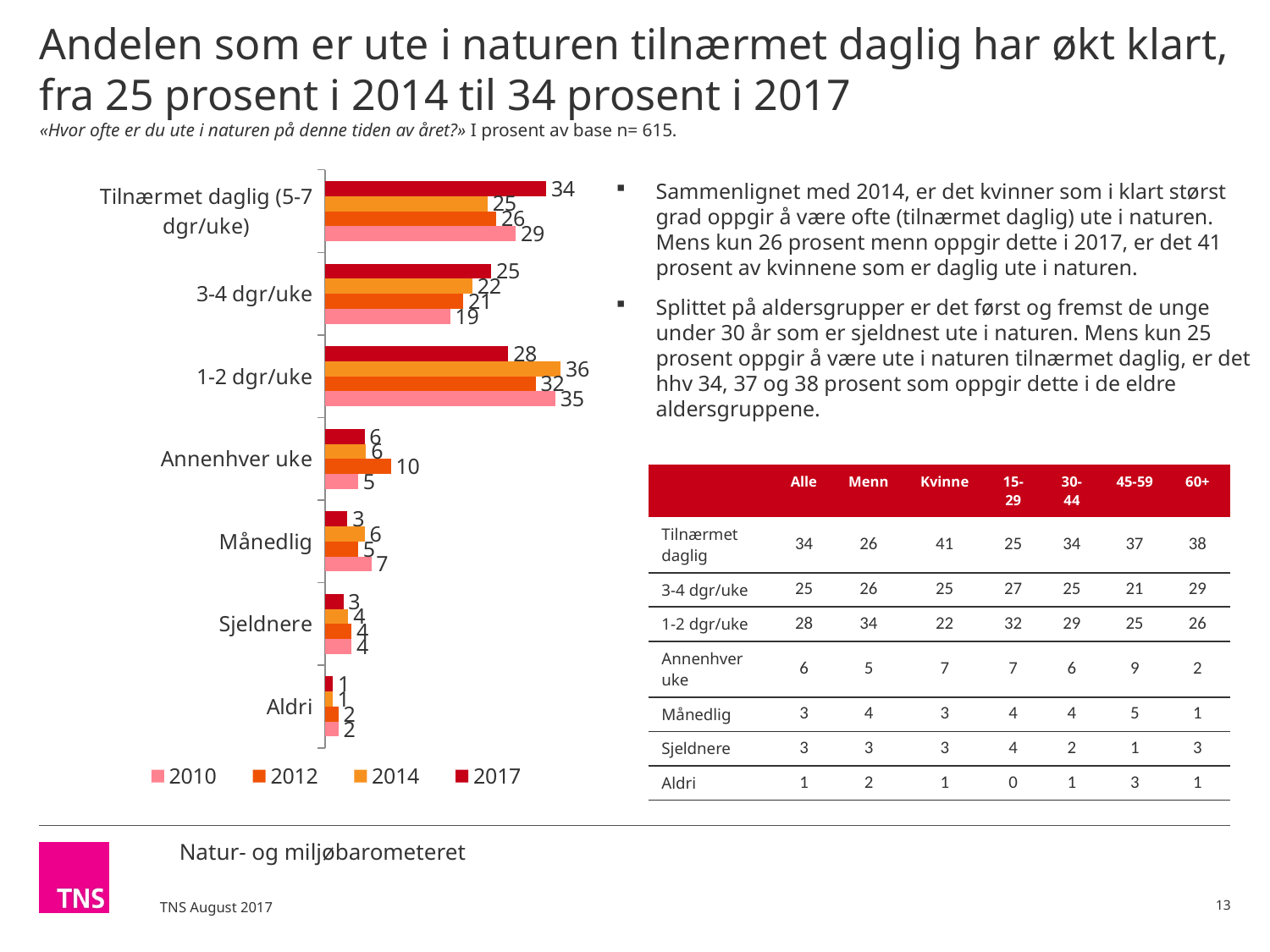
Which category has the highest 2017 value? Tilnærmet daglig (5-7 dgr/uke) For '1-2 dgr/uke', which year has the larger value, 2014 or 2017? 2014 What is the 2017 value for 'Tilnærmet daglig (5-7 dgr/uke)'? 34 How many categories are shown on the chart's vertical axis? 7 What kind of chart is shown on the slide? bar chart What is the 2014 value for '1-2 dgr/uke'? 36 What is the 2010 value for 'Tilnærmet daglig (5-7 dgr/uke)'? 29 What is the 2012 value for 'Annenhver uke'? 10 How many series does the chart legend list? 4 What is the 2017 value for '1-2 dgr/uke'? 28 Which years are listed in the chart legend? 2010, 2012, 2014, 2017 What is the difference between the 2017 and 2010 values for 'Tilnærmet daglig (5-7 dgr/uke)'? 5